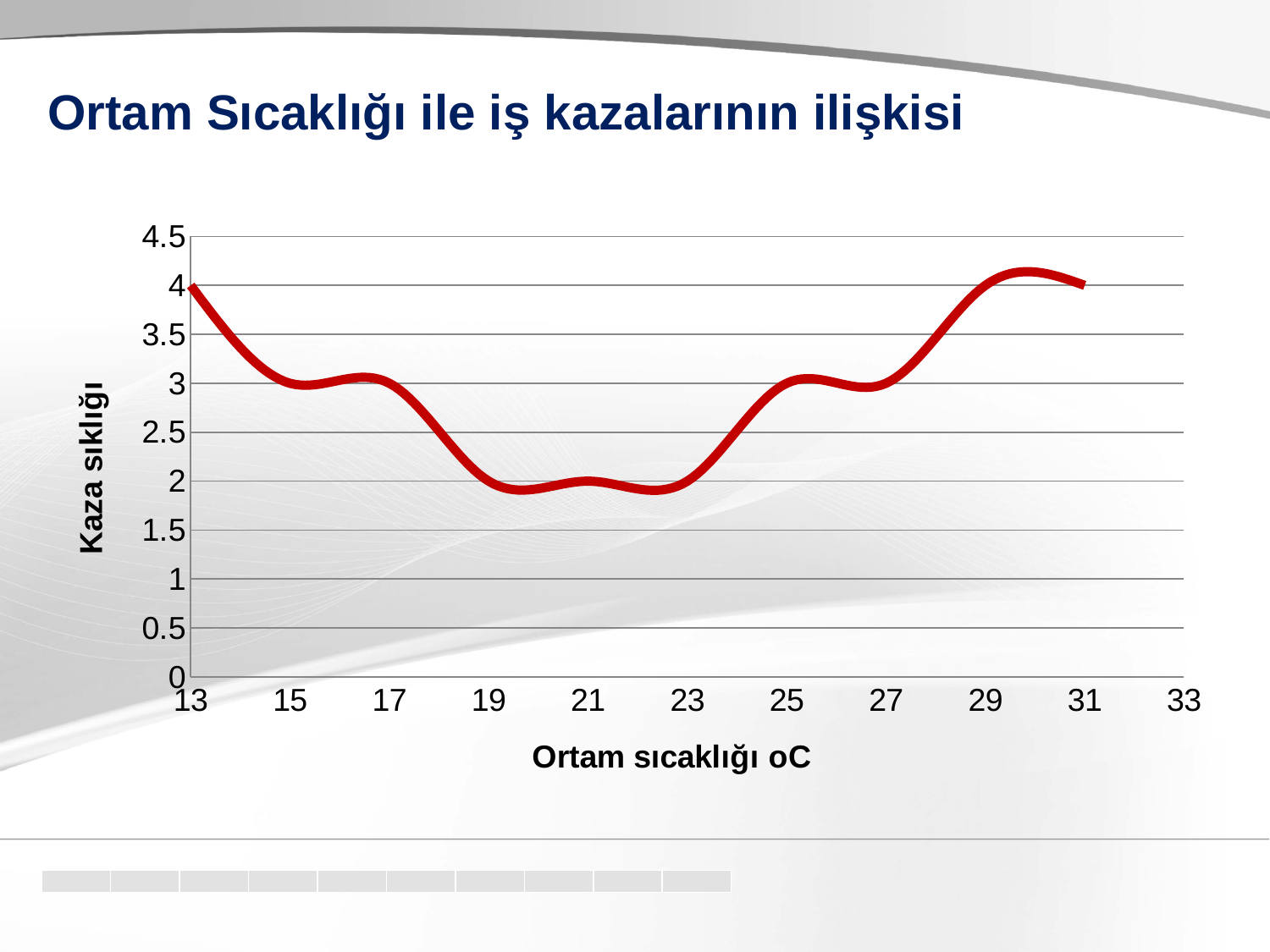
Is the accident frequency at 27 °C greater or less than 3.5? less What is the label of the vertical axis? Kaza sıklığı What kind of chart is shown on the slide? line chart Which has the higher accident frequency, 19 °C or 29 °C? 29 °C Does the accident frequency rise or fall as the temperature goes from 13 to 21? fall Which has the higher accident frequency, 13 °C or 21 °C? 13 °C Is the accident frequency at 13 °C greater or less than 3.5? greater Is the accident frequency at 21 °C greater or less than 2.5? less What is the title of the chart on the slide? Ortam Sıcaklığı ile iş kazalarının ilişkisi Does the accident frequency rise or fall as the temperature goes from 23 to 31? rise